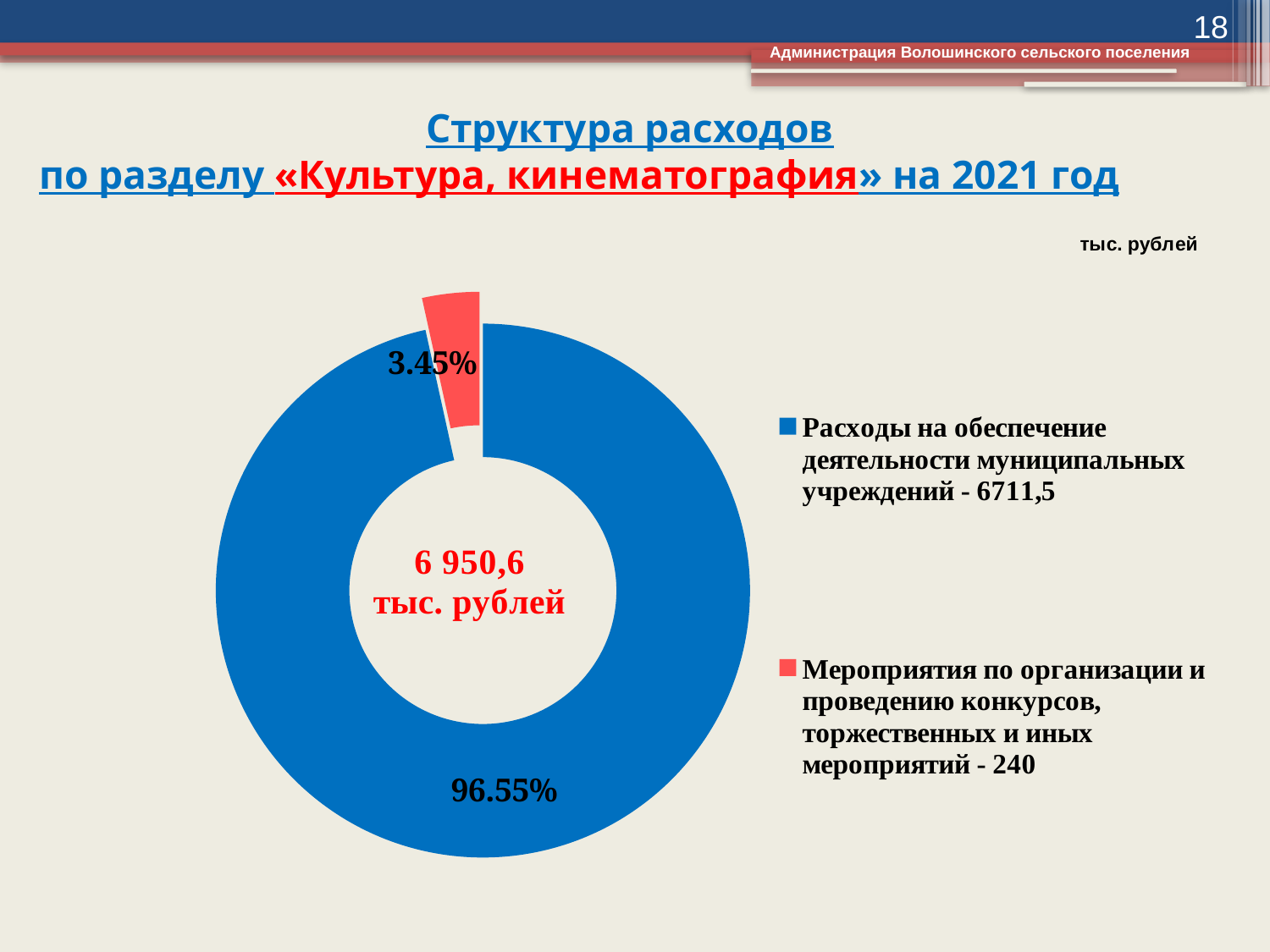
What colour is the slice for "Мероприятия по организации и проведению конкурсов, торжественных и иных мероприятий"? Red What value is given in the legend for "Расходы на обеспечение деятельности муниципальных учреждений"? 6711,5 How many categories does the chart show? 2 What kind of chart is shown on the slide? Doughnut (pie) chart What total amount is shown in the centre of the chart? 6 950,6 тыс. рублей Which category has the largest share of the chart? Расходы на обеспечение деятельности муниципальных учреждений What share of the chart does the slice "Мероприятия по организации и проведению конкурсов, торжественных и иных мероприятий" represent? 3.45% Which is larger: the value for "Расходы на обеспечение деятельности муниципальных учреждений" or the value for "Мероприятия по организации и проведению конкурсов, торжественных и иных мероприятий"? Расходы на обеспечение деятельности муниципальных учреждений What value is given in the legend for "Мероприятия по организации и проведению конкурсов, торжественных и иных мероприятий"? 240 What is the difference in percentage points between the two slices of the chart? 93.1 percentage points Which category has the smallest share of the chart? Мероприятия по организации и проведению конкурсов, торжественных и иных мероприятий What share of the chart does the slice "Расходы на обеспечение деятельности муниципальных учреждений" represent? 96.55%